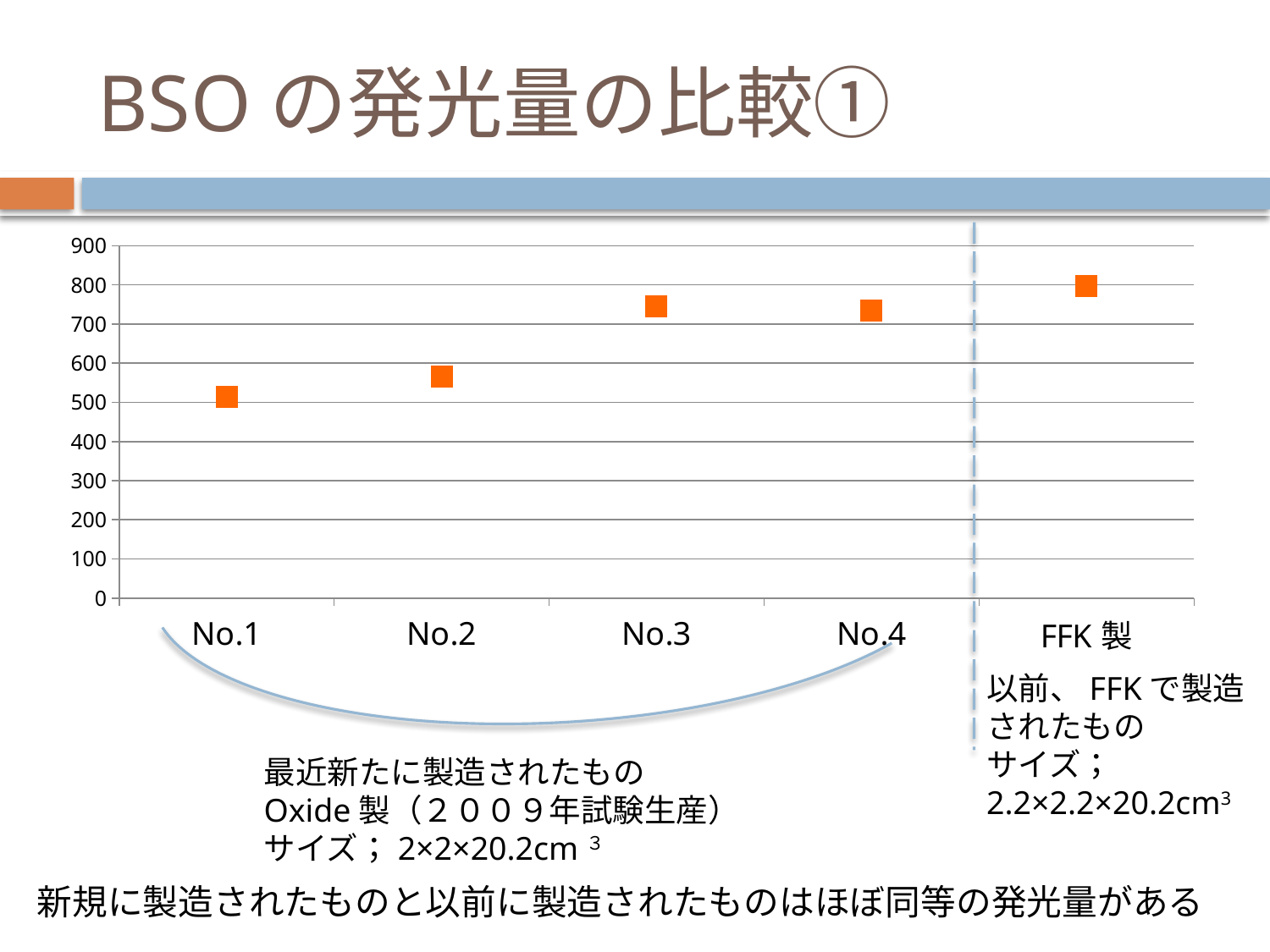
What colour are the data point markers in the chart? orange What kind of chart is shown on the slide? scatter chart Do the values generally rise or fall from No.1 to No.3? rise Is the value for No.2 greater or less than 500? greater Is the value for No.1 greater or less than 600? less Which category has the highest value in the chart? FFK製 Which is larger, the value for No.1 or the value for No.3? No.3 How many data points are plotted in the chart? 5 Is the value for No.4 greater or less than 600? greater Which category has the lowest value in the chart? No.1